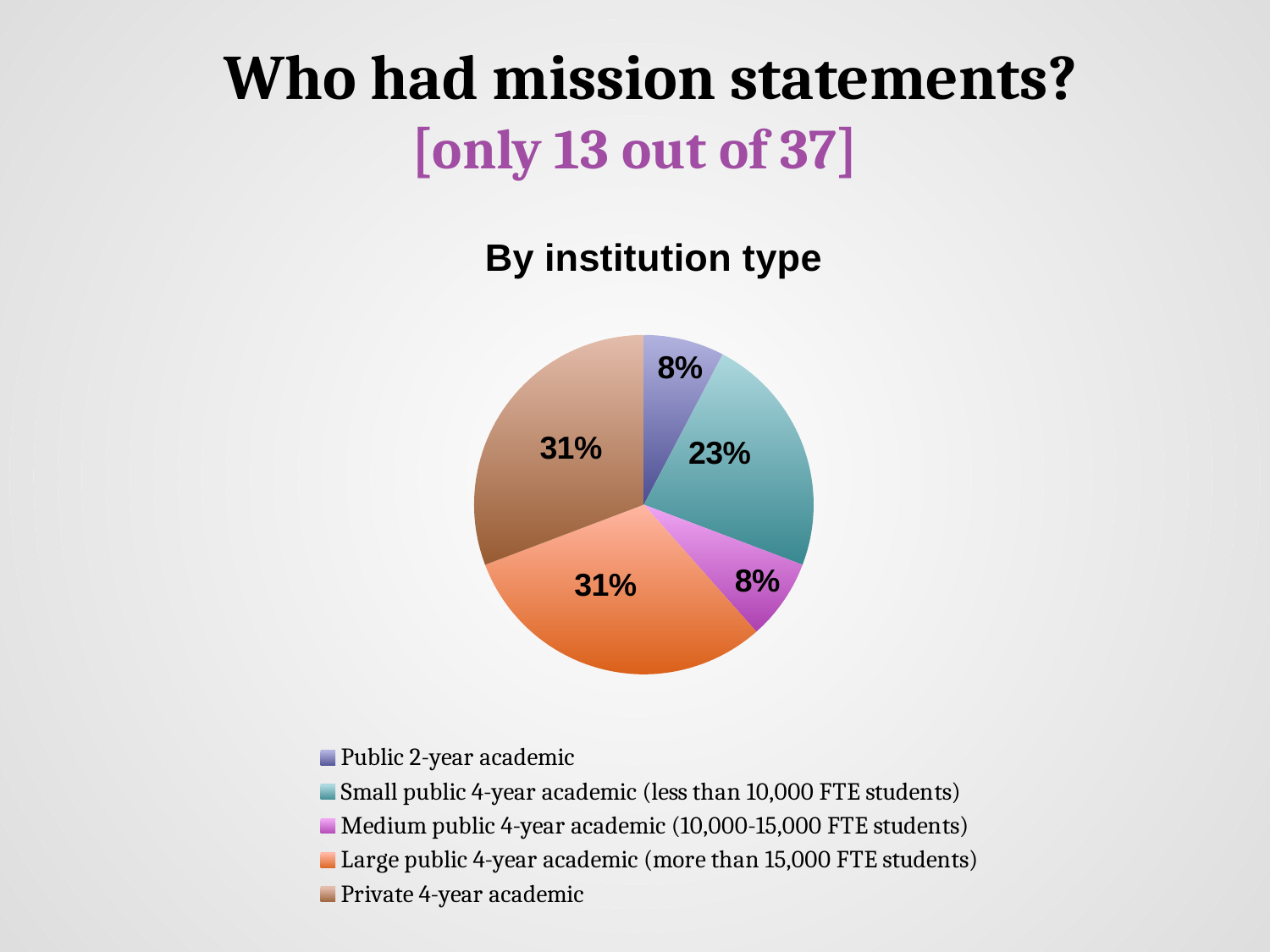
What percentage is shown for Public 2-year academic? 8% Which is larger: the share for Small public 4-year academic or the share for Medium public 4-year academic? Small public 4-year academic What share of the pie does Small public 4-year academic (less than 10,000 FTE students) represent? 23% What percentage is shown for Private 4-year academic? 31% How many slices does the pie chart have? 5 What is the difference in percentage points between Large public 4-year academic and Small public 4-year academic? 8 What is the difference in percentage points between Small public 4-year academic and Public 2-year academic? 15 Which is larger: the share for Private 4-year academic or the share for Public 2-year academic? Private 4-year academic What percentage is shown for Large public 4-year academic (more than 15,000 FTE students)? 31% What kind of chart is shown on the slide? Pie chart What percentage is shown for Medium public 4-year academic (10,000-15,000 FTE students)? 8% What is the title of the chart? By institution type